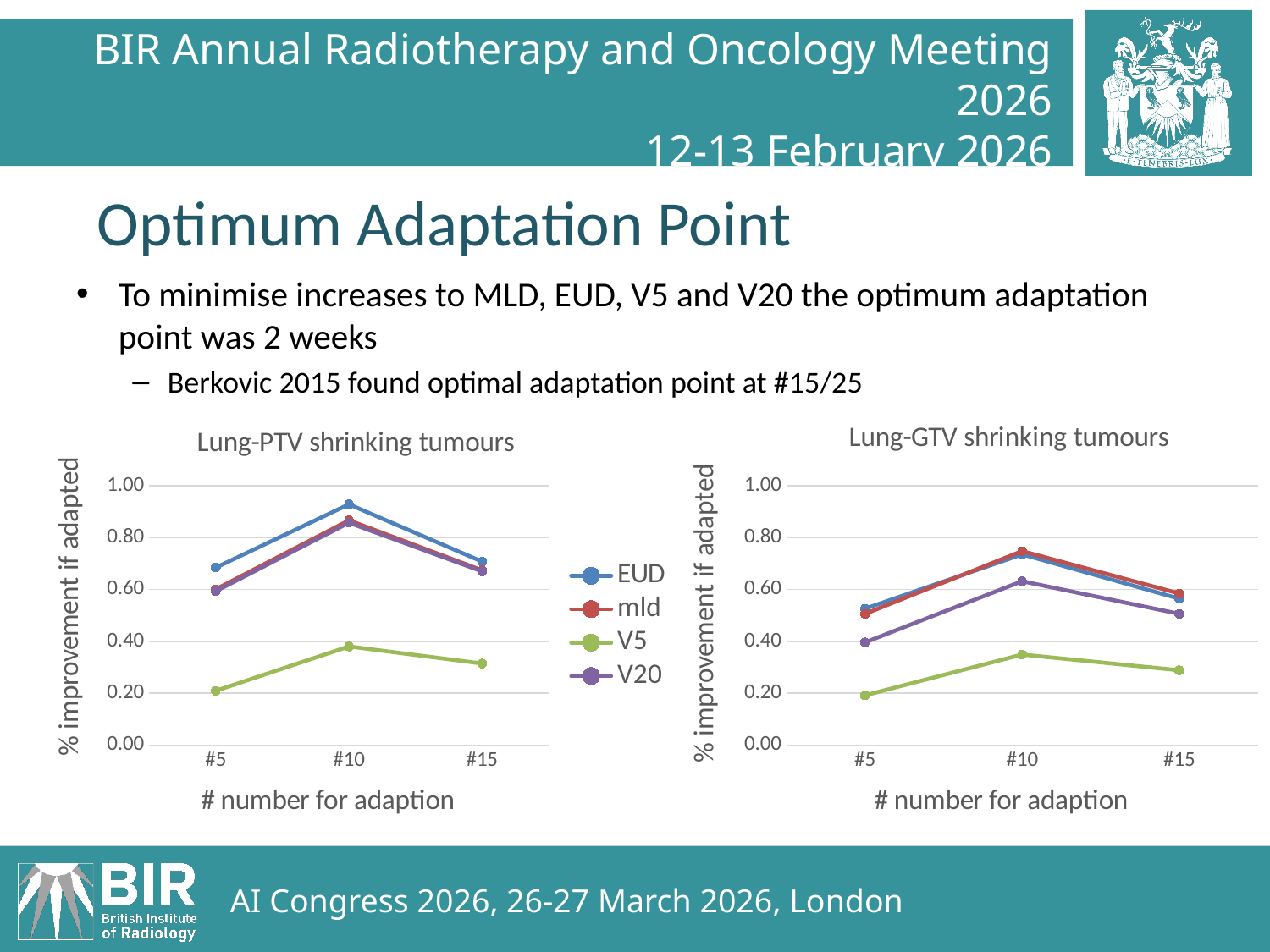
In the 'Lung-PTV shrinking tumours' chart, is the V5 value at #15 greater or less than 0.40? less In the 'Lung-GTV shrinking tumours' chart, which series has the lowest value at #10? V5 In the 'Lung-GTV shrinking tumours' chart, is the V5 value at #10 greater or less than 0.40? less How many points are plotted along the x axis of the 'Lung-GTV shrinking tumours' chart? 3 In the 'Lung-PTV shrinking tumours' chart, is the EUD value at #10 greater or less than 0.80? greater In the 'Lung-PTV shrinking tumours' chart, at which adaption number is the V5 series highest? #10 How many series does the legend list for the 'Lung-PTV shrinking tumours' chart? 4 In the 'Lung-PTV shrinking tumours' chart, which series has the highest value at #10? EUD In the 'Lung-PTV shrinking tumours' chart, does the EUD series rise or fall from #10 to #15? fall In the 'Lung-GTV shrinking tumours' chart, is the V20 value at #10 larger or smaller than the V5 value at #10? larger What type of chart is the 'Lung-PTV shrinking tumours' chart? line chart